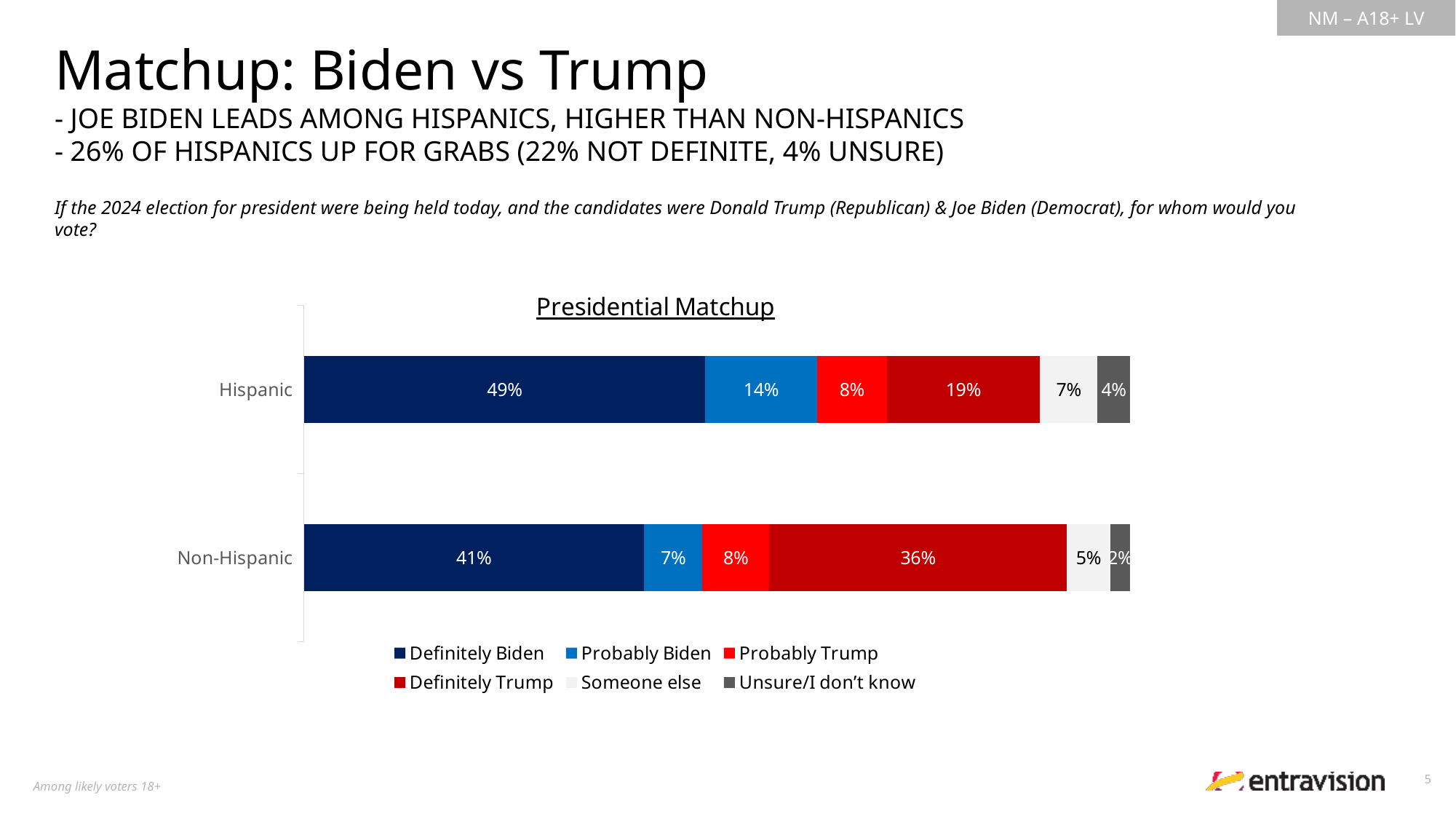
How many series does the legend list? 6 What is the Unsure/I don't know value for the Hispanic bar? 4% What type of chart is shown? Stacked bar chart What percentage of Hispanic respondents said Definitely Biden? 49% Which segment is the smallest in the Non-Hispanic bar? Unsure/I don't know Which group has the higher Definitely Biden share, Hispanic or Non-Hispanic? Hispanic What percentage of Non-Hispanic respondents said Definitely Trump? 36% How many categories (bars) are shown in the chart? 2 Which segment is the largest in the Hispanic bar? Definitely Biden What is the difference between the Definitely Trump values for Non-Hispanic and Hispanic respondents? 17% What is the Probably Biden value for the Non-Hispanic bar? 7% What is the difference between the Probably Biden values for Hispanic and Non-Hispanic respondents? 7%